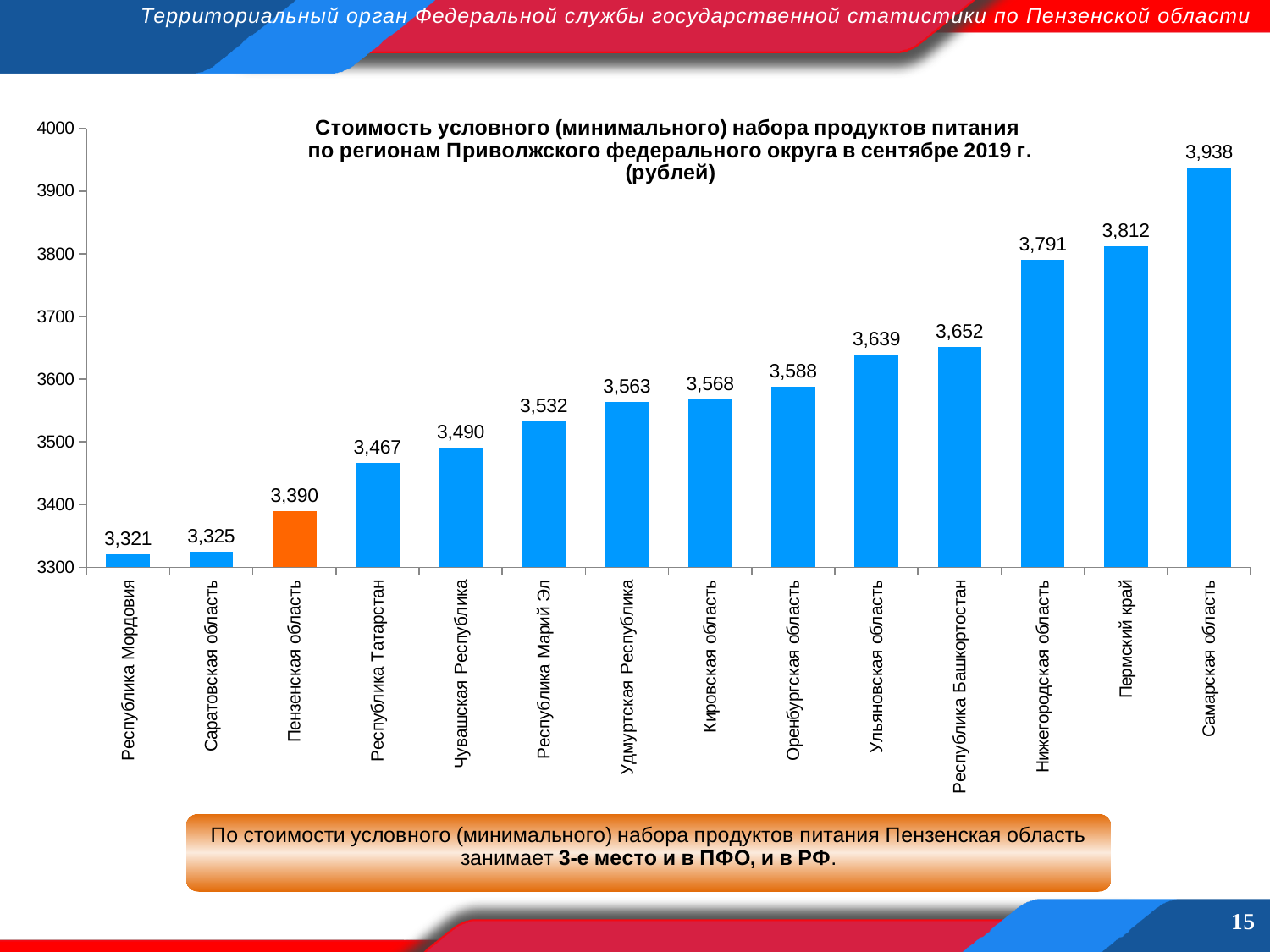
What is the difference between the values for Пензенская область and Республика Мордовия? 69 Which region's bar is highlighted in orange? Пензенская область What kind of chart is shown on the slide? Bar chart What is the value for Нижегородская область? 3,791 How many regions are shown in the chart? 14 What is the difference between the values for Самарская область and Пермский край? 126 What is the value for Пензенская область? 3,390 Do the values rise or fall from left to right along the x axis? Rise Which is larger, the value for Кировская область or the value for Ульяновская область? Ульяновская область Which region has the lowest value? Республика Мордовия Which region has the highest value? Самарская область What is the value for Республика Татарстан? 3,467